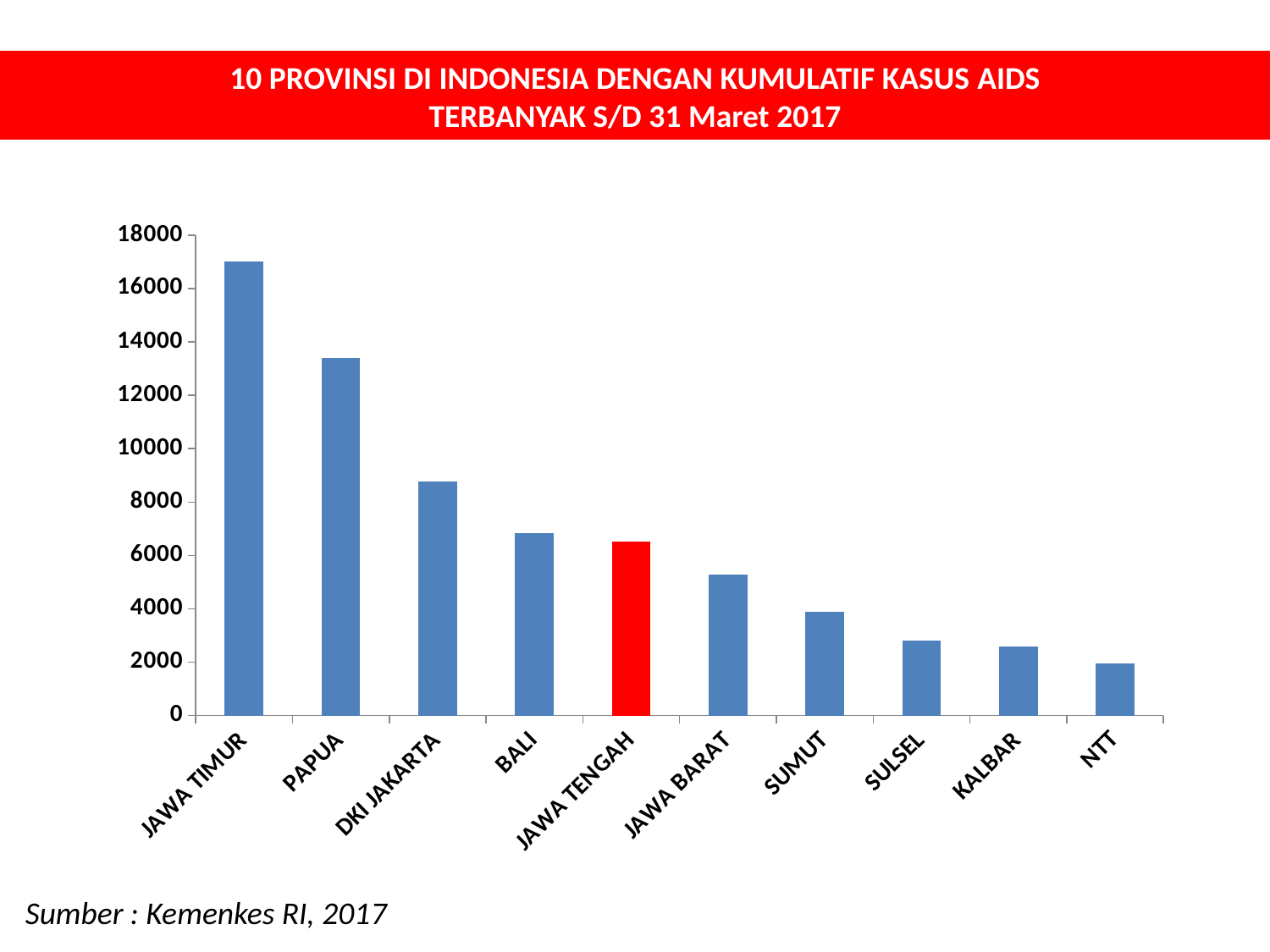
Is the value for PAPUA greater or less than 14000? less Which province's bar is coloured red instead of blue? JAWA TENGAH Which is larger, the value for JAWA BARAT or the value for SUMUT? JAWA BARAT What kind of chart is shown on the slide? bar chart How many provinces are shown in the chart? 10 Is the value for JAWA TIMUR greater or less than 16000? greater Which province has the highest bar in the chart? JAWA TIMUR Is the value for DKI JAKARTA greater or less than 8000? greater Which province has the lowest bar in the chart? NTT Which is larger, the value for PAPUA or the value for DKI JAKARTA? PAPUA